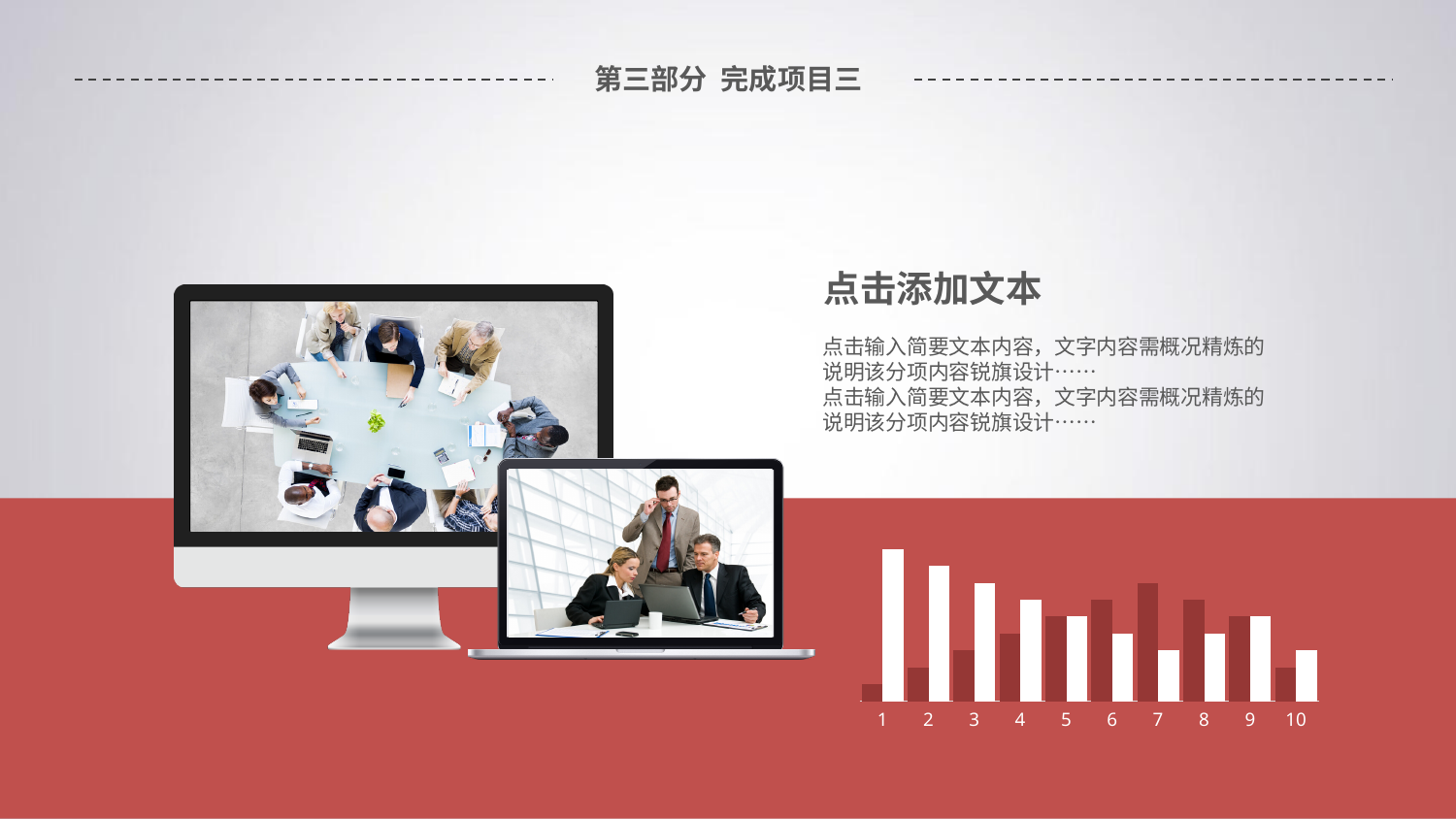
How many categories are shown on the x axis of the bar chart? 10 Which category has the tallest dark red bar in the bar chart? 7 How many bars are plotted for each category in the bar chart? 2 Which is taller, the white bar for category 1 or the white bar for category 10? category 1 For category 3, which bar is taller, the white bar or the dark red bar? the white bar Which is taller, the dark red bar for category 7 or the dark red bar for category 2? category 7 Do the white bars rise or fall from category 1 to category 10? fall Which category has the shortest dark red bar in the bar chart? 1 Which category has the tallest white bar in the bar chart? 1 What kind of chart is shown on the slide? bar chart